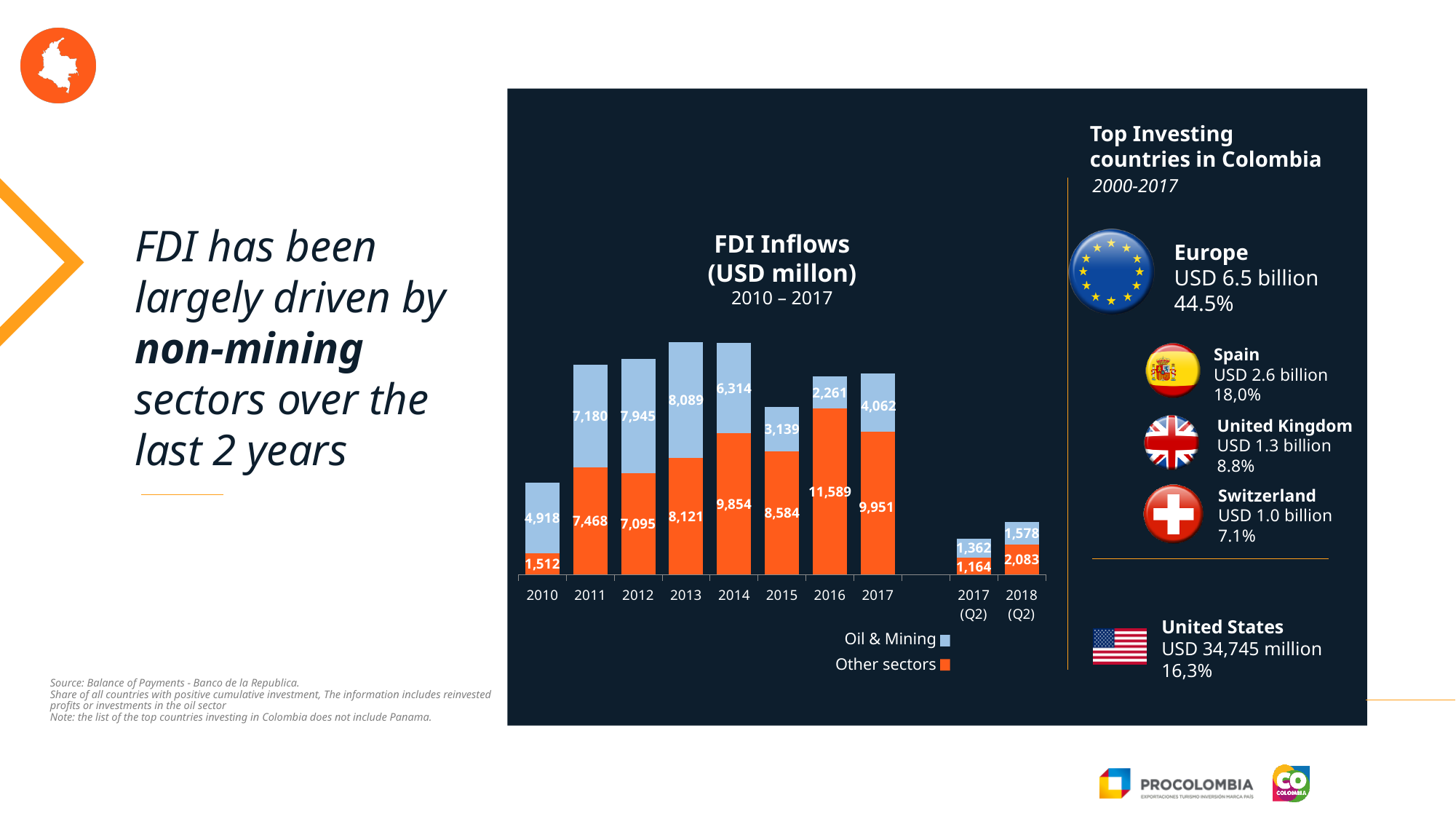
Which year has the highest Other sectors value? 2016 What is the Oil & Mining value for 2018 (Q2)? 1,578 How many series does the legend of the FDI Inflows chart list? 2 What is the Other sectors value for 2016 in the FDI Inflows chart? 11,589 What is the total FDI inflow (Oil & Mining plus Other sectors) for 2013? 16,210 What is the difference between the Other sectors value and the Oil & Mining value in 2016? 9,328 What is the Oil & Mining value for 2010 in the FDI Inflows chart? 4,918 Which period has the lowest Other sectors value? 2017 (Q2) What type of chart is shown on the slide? Stacked bar chart How many bars (periods) are shown in the FDI Inflows chart? 10 Which colour represents Other sectors in the FDI Inflows chart? Orange In 2010, which is larger: the Oil & Mining value or the Other sectors value? Oil & Mining